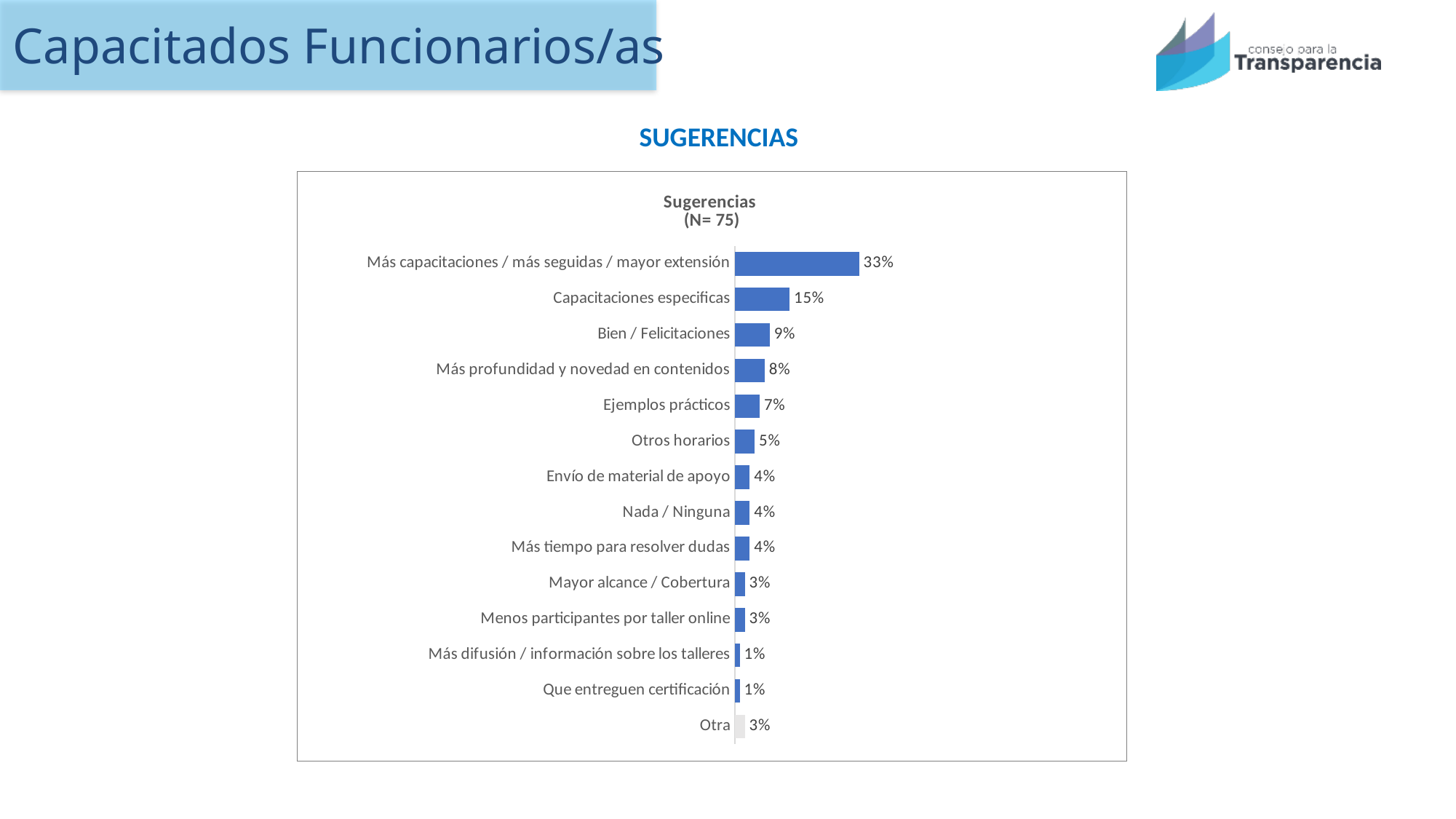
What is the value for "Ejemplos prácticos"? 7% What is the difference between "Bien / Felicitaciones" and "Otros horarios"? 4% What is the value for "Más capacitaciones / más seguidas / mayor extensión"? 33% Which category's bar is shown in a different colour (grey) from the others? Otra What is the sample size (N) stated in the chart title? 75 Which is larger, "Más profundidad y novedad en contenidos" or "Envío de material de apoyo"? Más profundidad y novedad en contenidos Which category has the highest value? Más capacitaciones / más seguidas / mayor extensión What kind of chart is shown on the slide? Bar chart What is the difference between "Más capacitaciones / más seguidas / mayor extensión" and "Capacitaciones especificas"? 18% What is the value for "Capacitaciones especificas"? 15% How many categories are shown in the chart? 14 What is the value for "Otra"? 3%